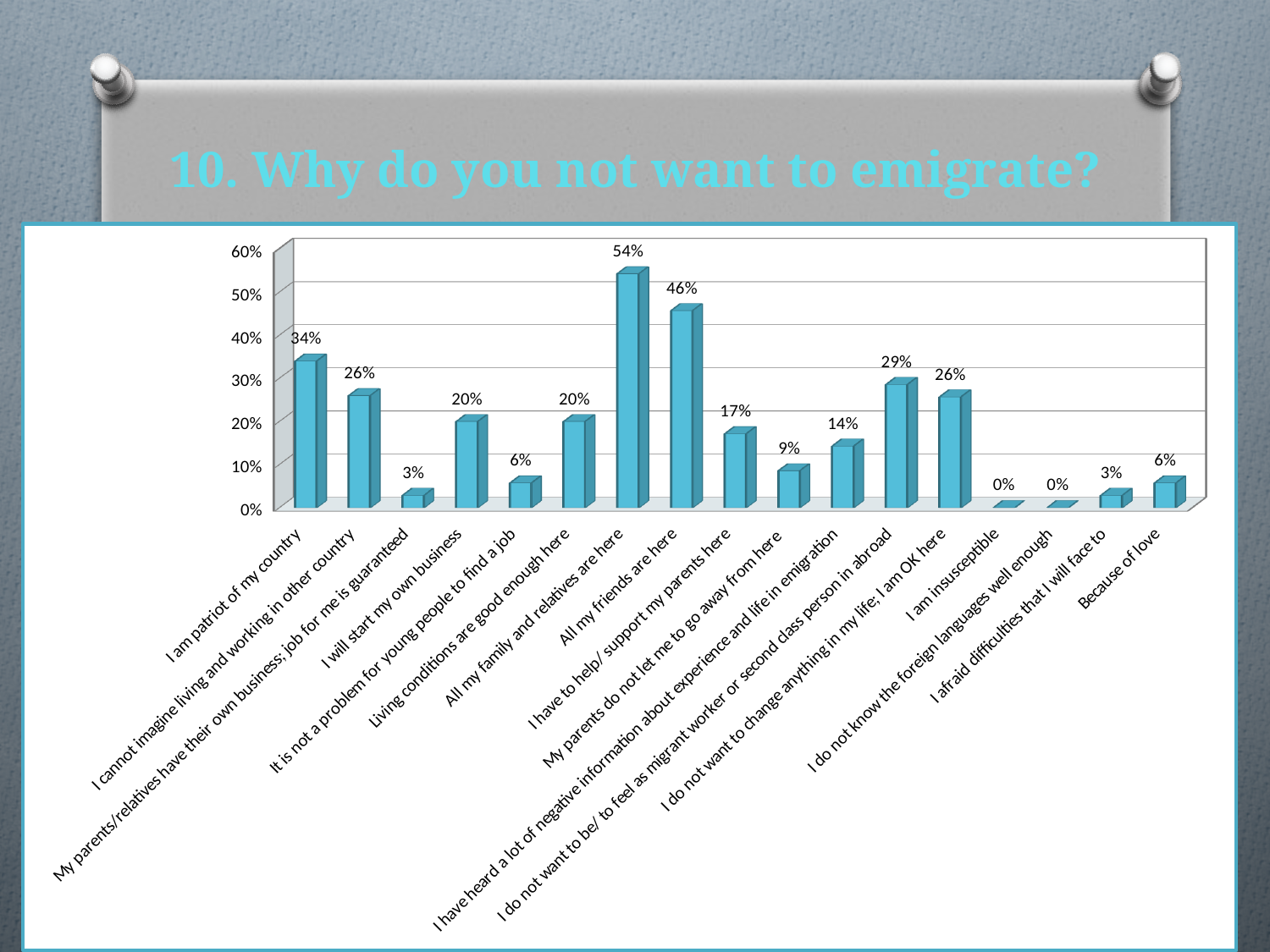
Which is larger: "My parents do not let me to go away from here" or "I have heard a lot of negative information about experience and life in emigration"? I have heard a lot of negative information about experience and life in emigration What is the difference between "I am patriot of my country" and "I have to help/ support my parents here"? 17% How many reasons (categories) are shown on the chart? 17 What is the value for "I am patriot of my country"? 34% What percentage of respondents chose "All my family and relatives are here"? 54% What percentage is shown for "I do not want to be/ to feel as migrant worker or second class person in abroad"? 29% How many categories have a value of 0%? 2 What is the difference between "All my family and relatives are here" and "All my friends are here"? 8% Which reason has the highest percentage? All my family and relatives are here What type of chart is shown on the slide? Bar chart What is the value for "Because of love"? 6% Which is larger: "I cannot imagine living and working in other country" or "I will start my own business"? I cannot imagine living and working in other country